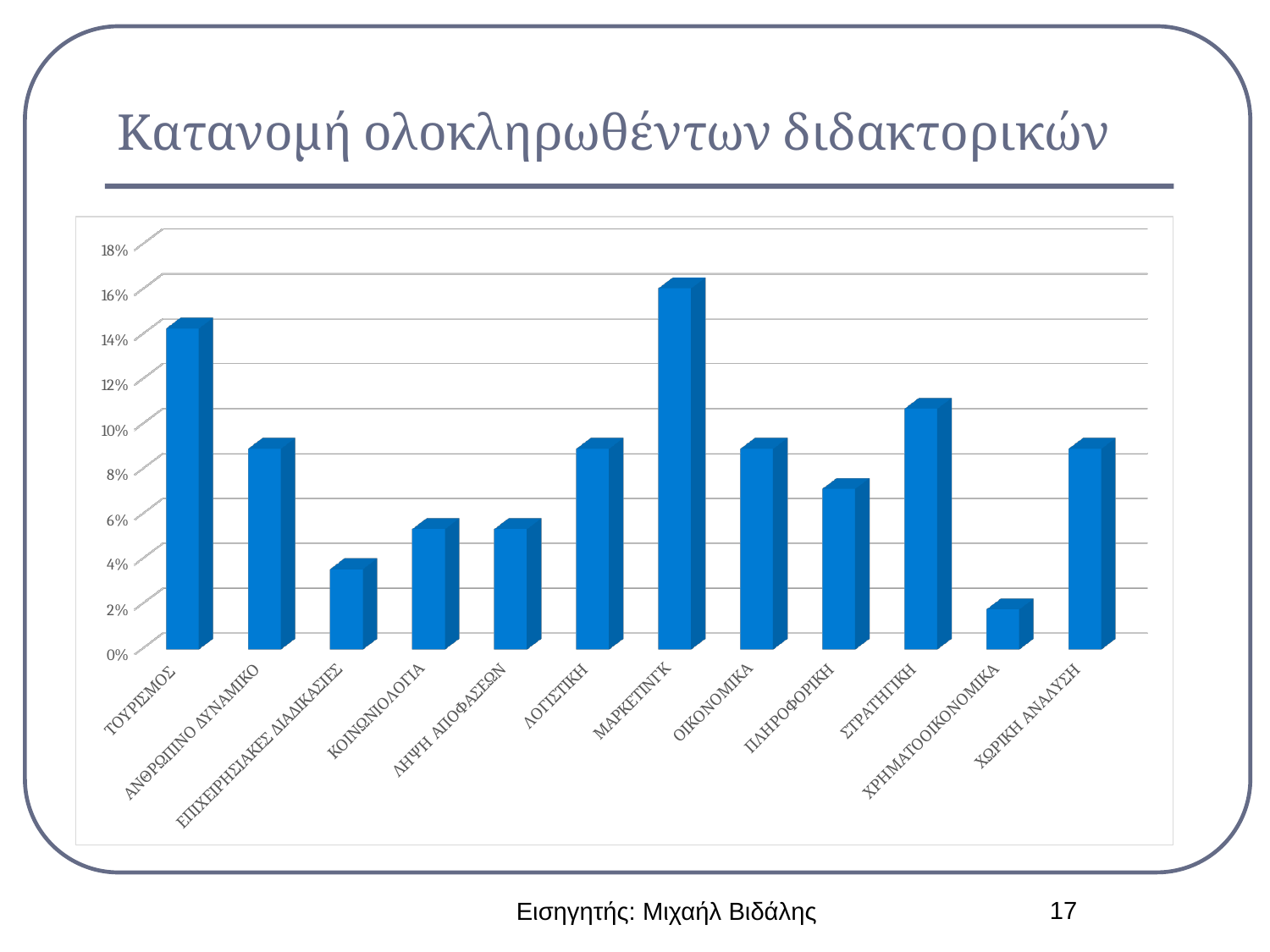
Is the value for ΣΤΡΑΤΗΓΙΚΗ greater or less than 8%? greater Which is larger, the value for ΚΟΙΝΩΝΙΟΛΟΓΙΑ or the value for ΧΡΗΜΑΤΟΟΙΚΟΝΟΜΙΚΑ? ΚΟΙΝΩΝΙΟΛΟΓΙΑ Which is larger, the value for ΤΟΥΡΙΣΜΟΣ or the value for ΣΤΡΑΤΗΓΙΚΗ? ΤΟΥΡΙΣΜΟΣ Is the value for ΤΟΥΡΙΣΜΟΣ greater or less than 12%? greater Which category has the lowest value in the chart? ΧΡΗΜΑΤΟΟΙΚΟΝΟΜΙΚΑ What colour are the bars in the chart? Blue What is the title of the chart? Κατανομή ολοκληρωθέντων διδακτορικών What type of chart is shown on the slide? Bar chart Which category has the highest value in the chart? ΜΑΡΚΕΤΙΝΓΚ Is the value for ΧΡΗΜΑΤΟΟΙΚΟΝΟΜΙΚΑ greater or less than 4%? less How many categories are shown on the x axis of the chart? 12